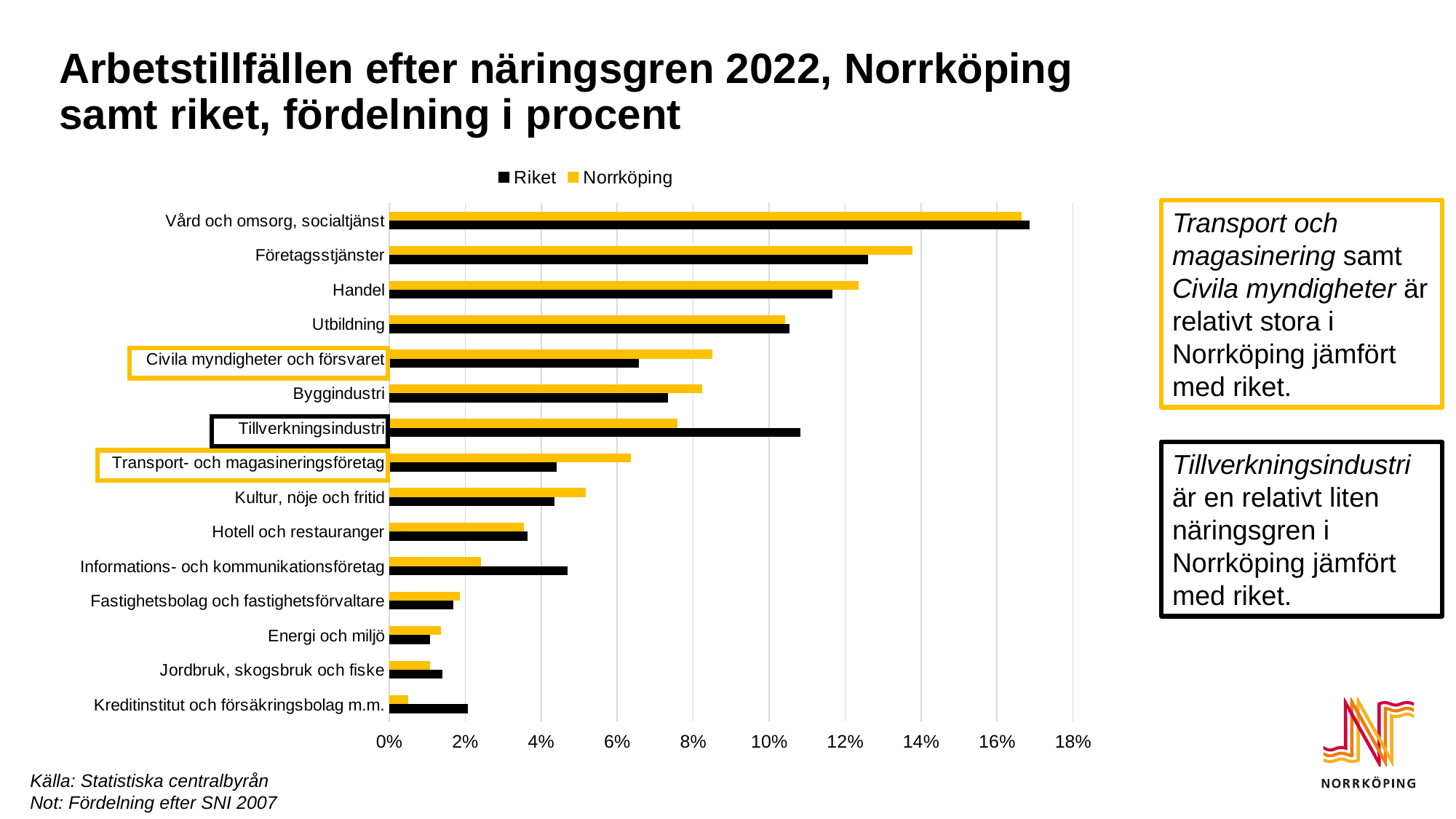
What source is cited for the chart data? Statistiska centralbyrån For Tillverkningsindustri, which is larger: the value for Riket or for Norrköping? Riket Which category has the lowest value for Norrköping? Kreditinstitut och försäkringsbolag m.m. Is the Riket value for Tillverkningsindustri greater or less than 10%? greater How many industry categories are plotted on the chart? 15 Which colour represents Norrköping in the chart? Yellow Is the Norrköping value for Civila myndigheter och försvaret greater or less than 8%? greater Is the Norrköping value for Informations- och kommunikationsföretag greater or less than 4%? less How many series does the legend list? 2 What kind of chart is shown on the slide? Bar chart Which category has the highest value for Norrköping? Vård och omsorg, socialtjänst For Transport- och magasineringsföretag, which is larger: the value for Riket or for Norrköping? Norrköping